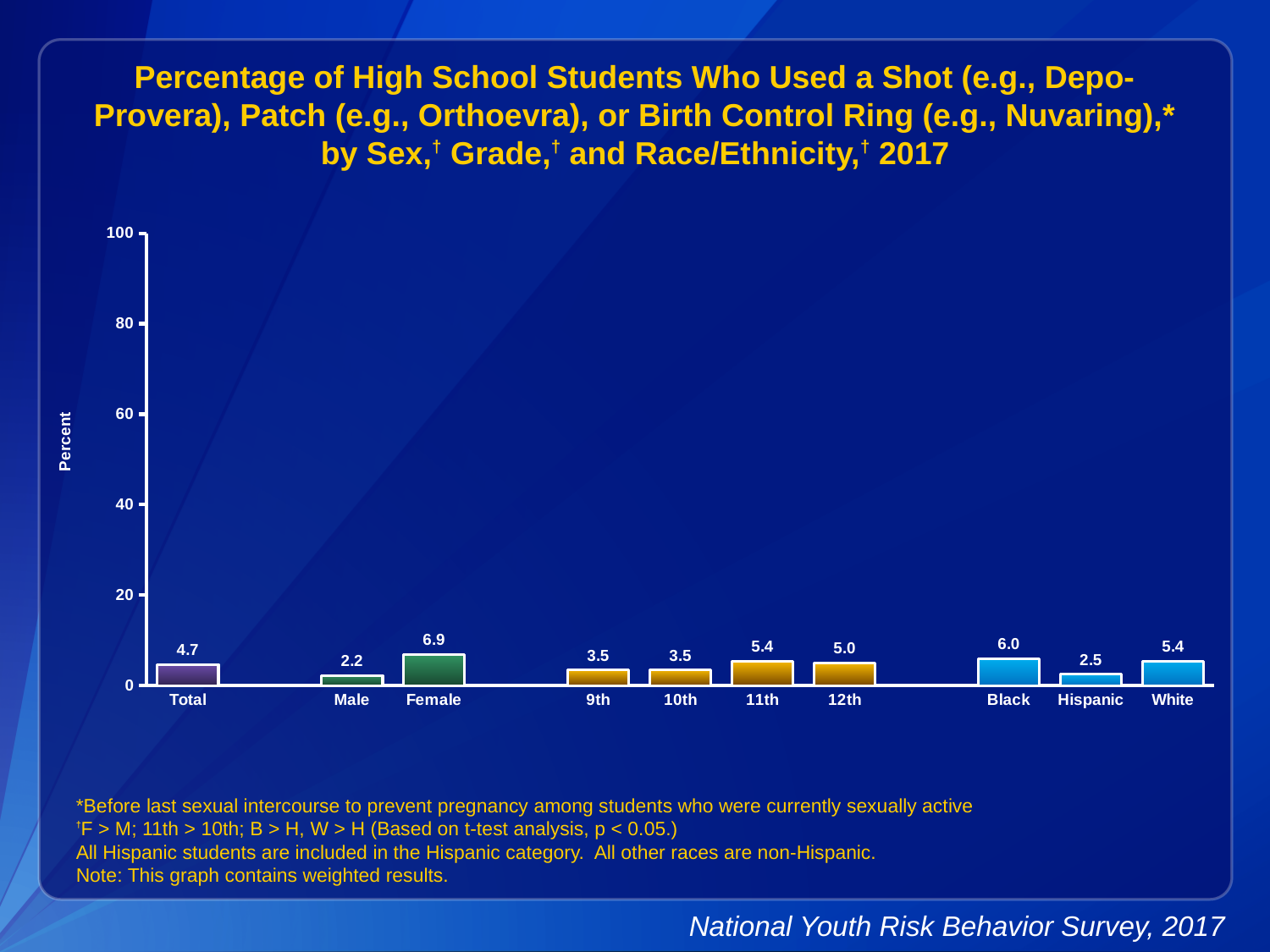
Which is larger, the value for Black or the value for White? Black Which category has the highest value? Female What is the difference between the values for Female and Male? 4.7 What is the value for Hispanic? 2.5 Which category has the lowest value? Male Do the values rise or fall from 9th to 11th grade? rise What is the label of the y axis? Percent Is the value for 11th greater or less than 20? less What kind of chart is this? bar chart How many categories are shown on the x axis? 10 What is the value for Total? 4.7 What is the value for Female? 6.9